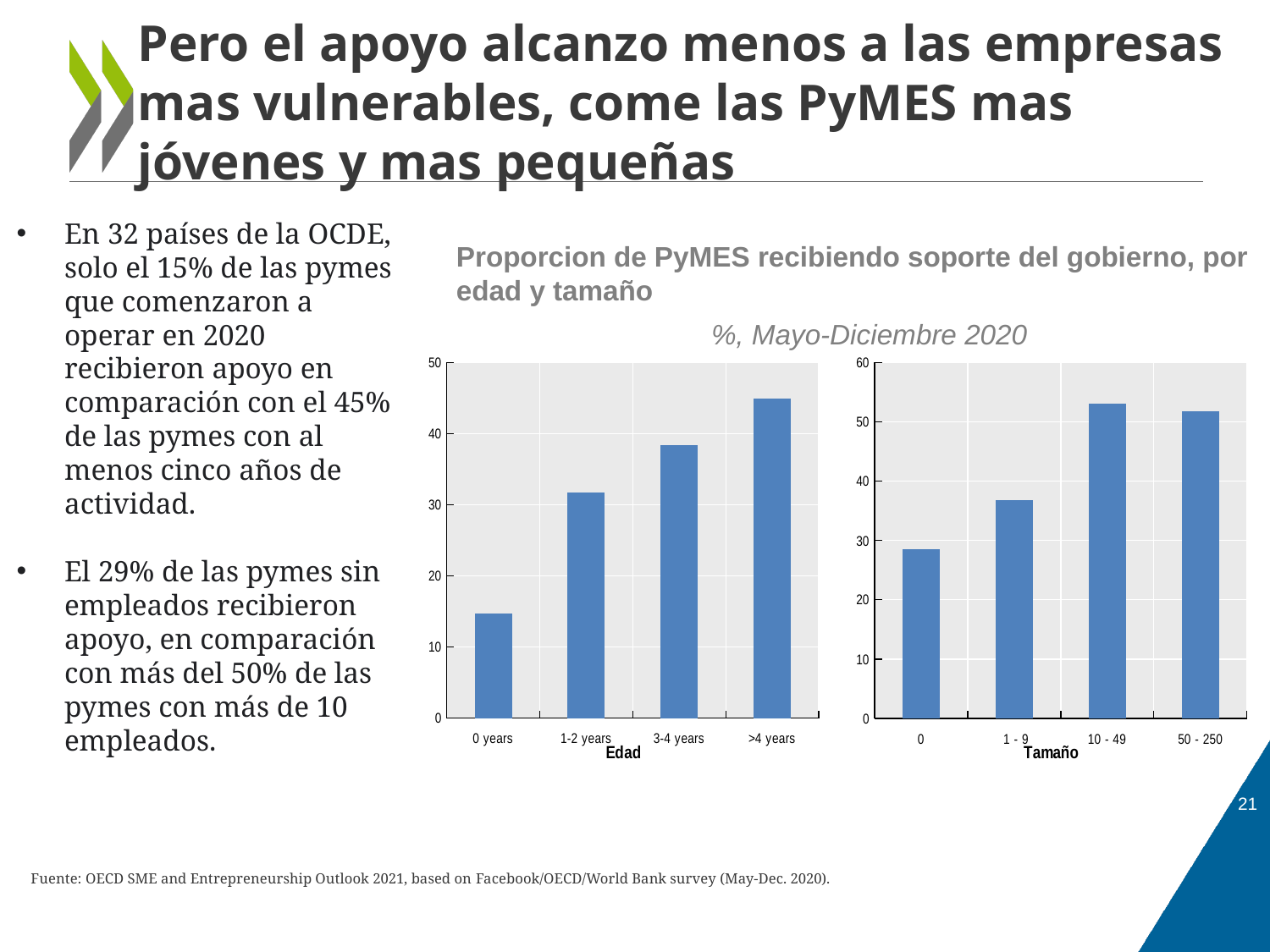
In the Tamaño chart, which size category has the lowest share of SMEs receiving government support? 0 In the Edad chart, which age category has the highest share of SMEs receiving government support? >4 years What kind of chart is the Tamaño chart? bar chart In the Tamaño chart, which is larger, the value for 1 - 9 or the value for 50 - 250? 50 - 250 In the Edad chart, is the value for >4 years greater or less than 40? greater In the Edad chart, is the value for 1-2 years greater or less than 30? greater In the Edad chart, how many age categories are shown? 4 In the Tamaño chart, is the value for 10 - 49 greater or less than 50? greater In the Edad chart, do the values rise or fall as firm age increases along the x axis? rise In the Edad chart, which age category has the lowest share of SMEs receiving government support? 0 years